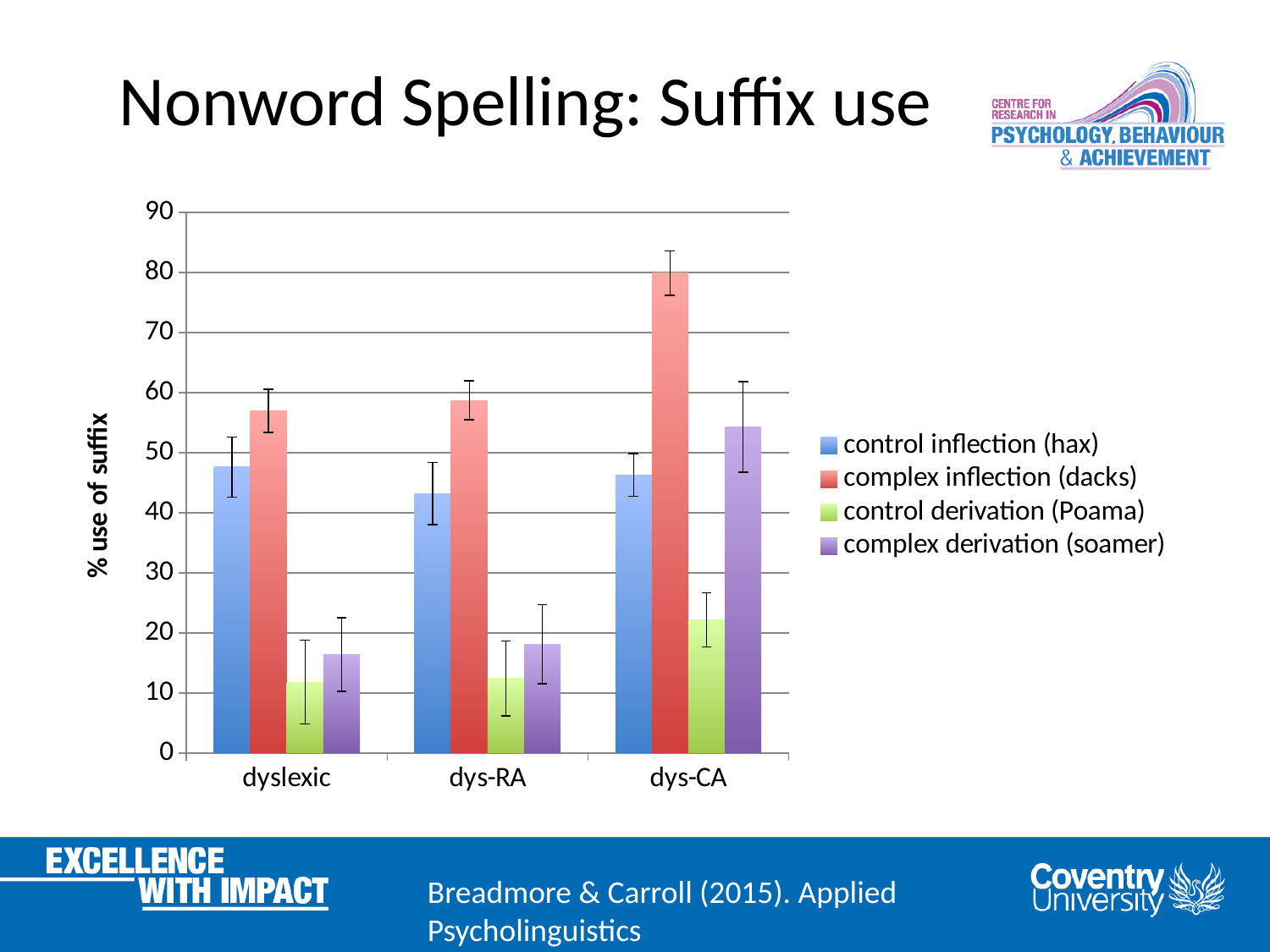
How many series does the legend list? 4 Which group has the highest value for complex inflection (dacks)? dys-CA Within the dyslexic group, which is larger: control inflection (hax) or complex inflection (dacks)? complex inflection (dacks) Is the value for complex derivation (soamer) in the dys-CA group greater or less than 40? greater Is the value for control inflection (hax) in the dys-RA group greater or less than 50? less Which group has the larger value for complex derivation (soamer): dyslexic or dys-CA? dys-CA How many groups are shown along the x axis? 3 Which series has the lowest value in the dys-CA group? control derivation (Poama) Is the value for complex inflection (dacks) in the dys-CA group greater or less than 70? greater What kind of chart is shown on the slide? bar chart What is the label on the y axis? % use of suffix